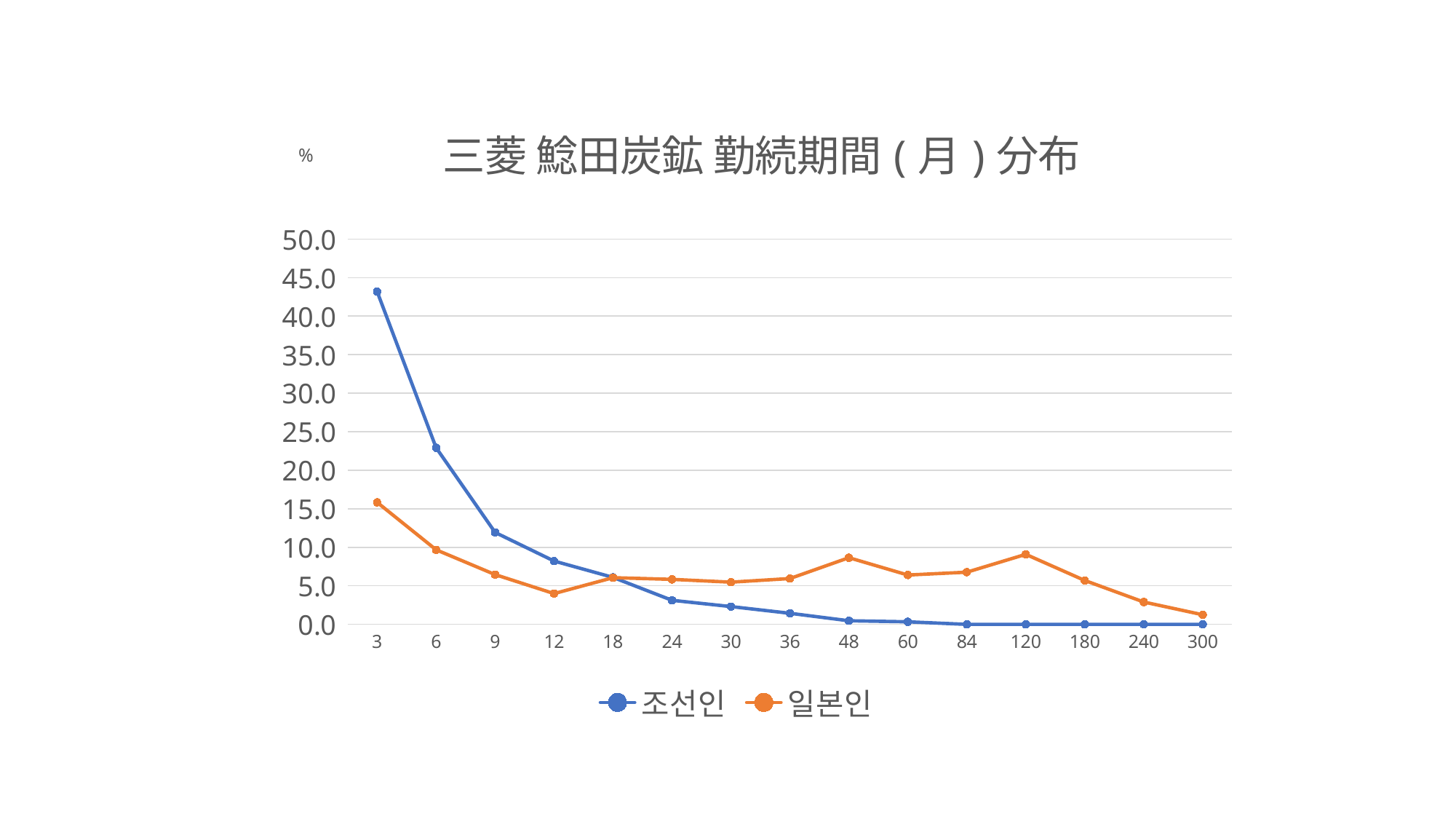
At which x-axis category is the value for 일본인 lowest? 300 Is the value for 일본인 at x = 12 greater or less than 5.0? less How many points are plotted along the x axis for each series? 15 At which x-axis category is the value for 일본인 highest? 3 At x = 3, which series has the larger value, 조선인 or 일본인? 조선인 Does the 조선인 series generally rise or fall as you move along the x axis? fall What is the title of the chart? 三菱 鯰田炭鉱 勤続期間 ( 月 ) 分布 At x = 48, which series has the larger value, 조선인 or 일본인? 일본인 How many series does the legend list? 2 Is the value for 조선인 at x = 3 greater or less than 40.0? greater What kind of chart is shown on the slide? line chart At which x-axis category is the value for 조선인 highest? 3